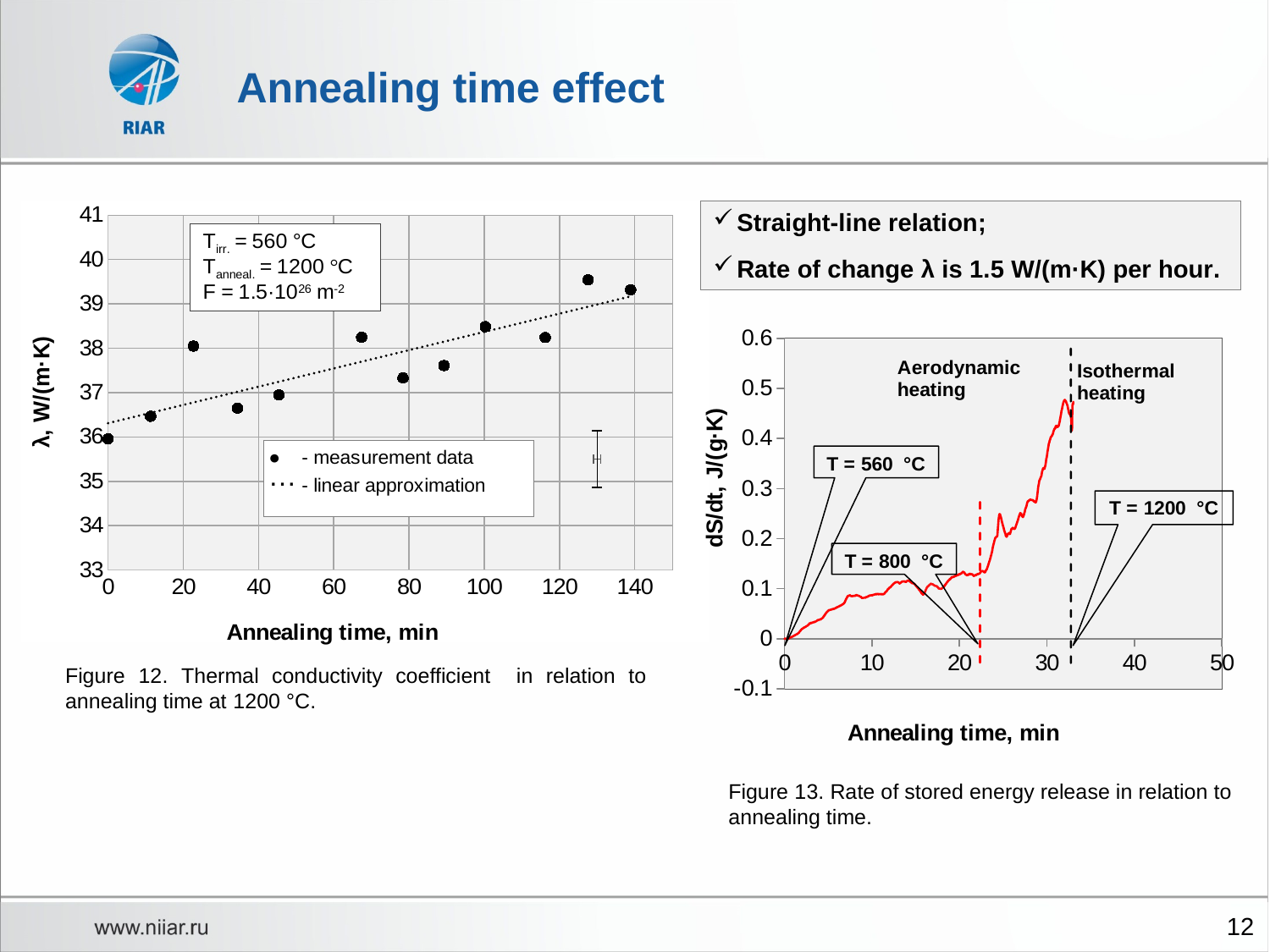
In Figure 12, do the measurement data values generally rise or fall as annealing time increases? rise In Figure 13, what is the highest value shown on the x axis? 50 In Figure 13, does dS/dt generally rise or fall from 0 min to about 32 min? rise In Figure 13, is the value of dS/dt at 10 min greater or less than 0.2? less What kind of chart is Figure 12 (the left chart)? scatter chart In Figure 12, what is the label of the y axis? λ, W/(m·K) In Figure 12, is the measurement value at annealing time 0 min greater or less than 37? less In Figure 12, is the measurement value at about 128 min greater or less than 39? greater What kind of chart is Figure 13 (the right chart)? line chart In Figure 12, what are the two legend entries? measurement data; linear approximation In Figure 12, how many series does the legend list? 2